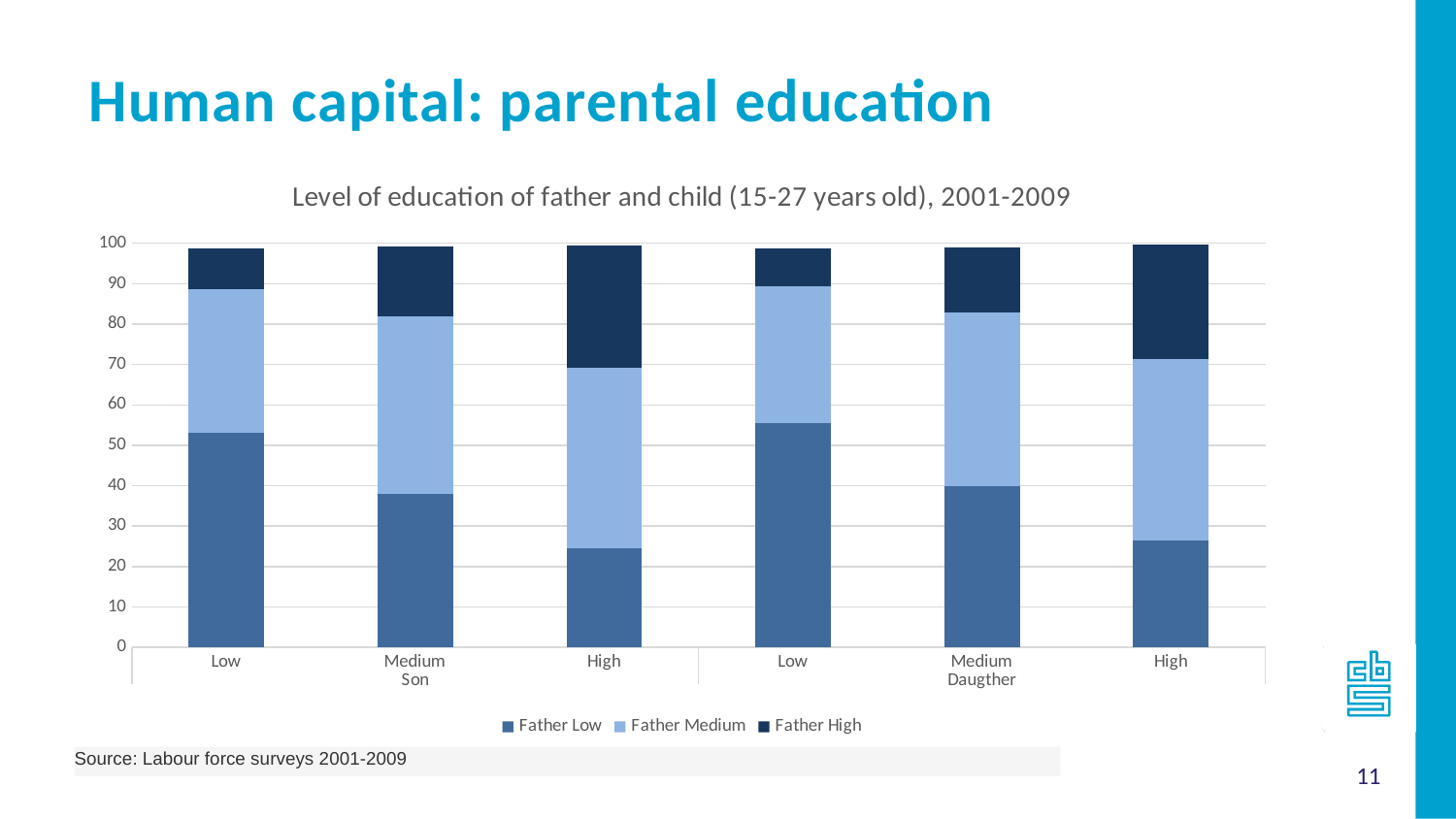
Is the Father Low value for Son Low greater or less than 50? greater Among the Son categories, which has the largest Father Low segment? Low Is the Father Low value for Daughter Low greater or less than 50? greater Is the Father Low value for Daughter Medium greater or less than 50? less What are the three series named in the legend? Father Low, Father Medium, Father High Which is larger, the Father Low segment for Son Low or for Son High? Son Low How many bars are plotted in the chart? 6 How many series does the legend list? 3 Does the Father Low segment rise or fall across the Son categories from Low to High? fall What kind of chart is shown on the slide? Stacked bar chart What is the title of the chart? Level of education of father and child (15-27 years old), 2001-2009